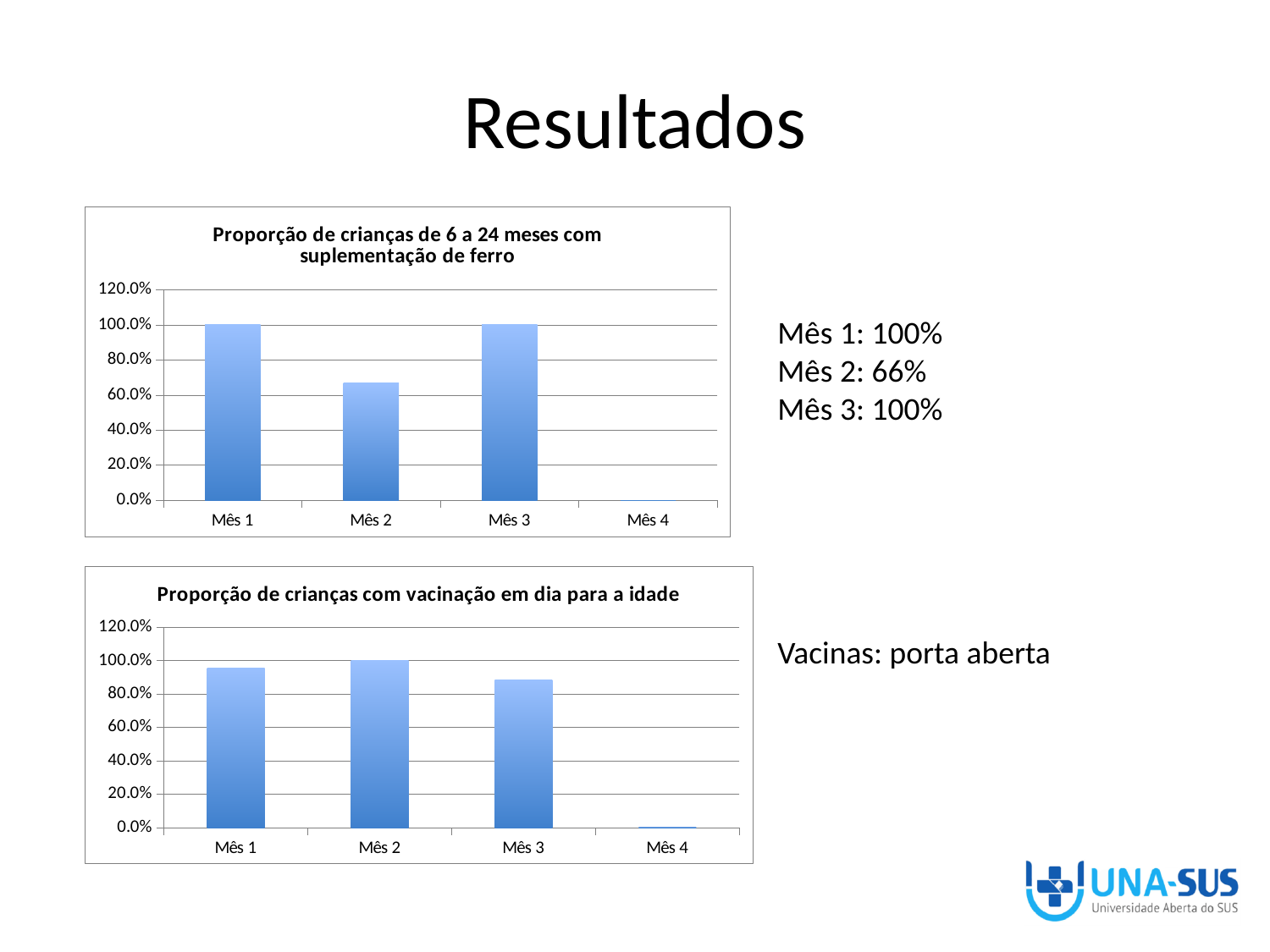
In the top chart (suplementação de ferro), what is the value for Mês 3? 100% In the bottom chart (vacinação em dia), is the value for Mês 3 greater or less than 80.0%? greater In the top chart (suplementação de ferro), which month has the lowest value? Mês 4 In the bottom chart (vacinação em dia), which month has the lowest value? Mês 4 In the bottom chart (vacinação em dia), is the value for Mês 4 greater or less than 20.0%? less What kind of chart is the bottom chart (Proporção de crianças com vacinação em dia para a idade)? Bar chart In the bottom chart (vacinação em dia), which month has the highest value? Mês 2 In the bottom chart (vacinação em dia), what is the value for Mês 2? 100.0% In the top chart (Proporção de crianças de 6 a 24 meses com suplementação de ferro), what is the value for Mês 1? 100% In the top chart (suplementação de ferro), which is larger, Mês 1 or Mês 2? Mês 1 In the top chart (suplementação de ferro), is the value for Mês 2 greater or less than 80.0%? less How many months are shown on the x axis of the top chart (suplementação de ferro)? 4